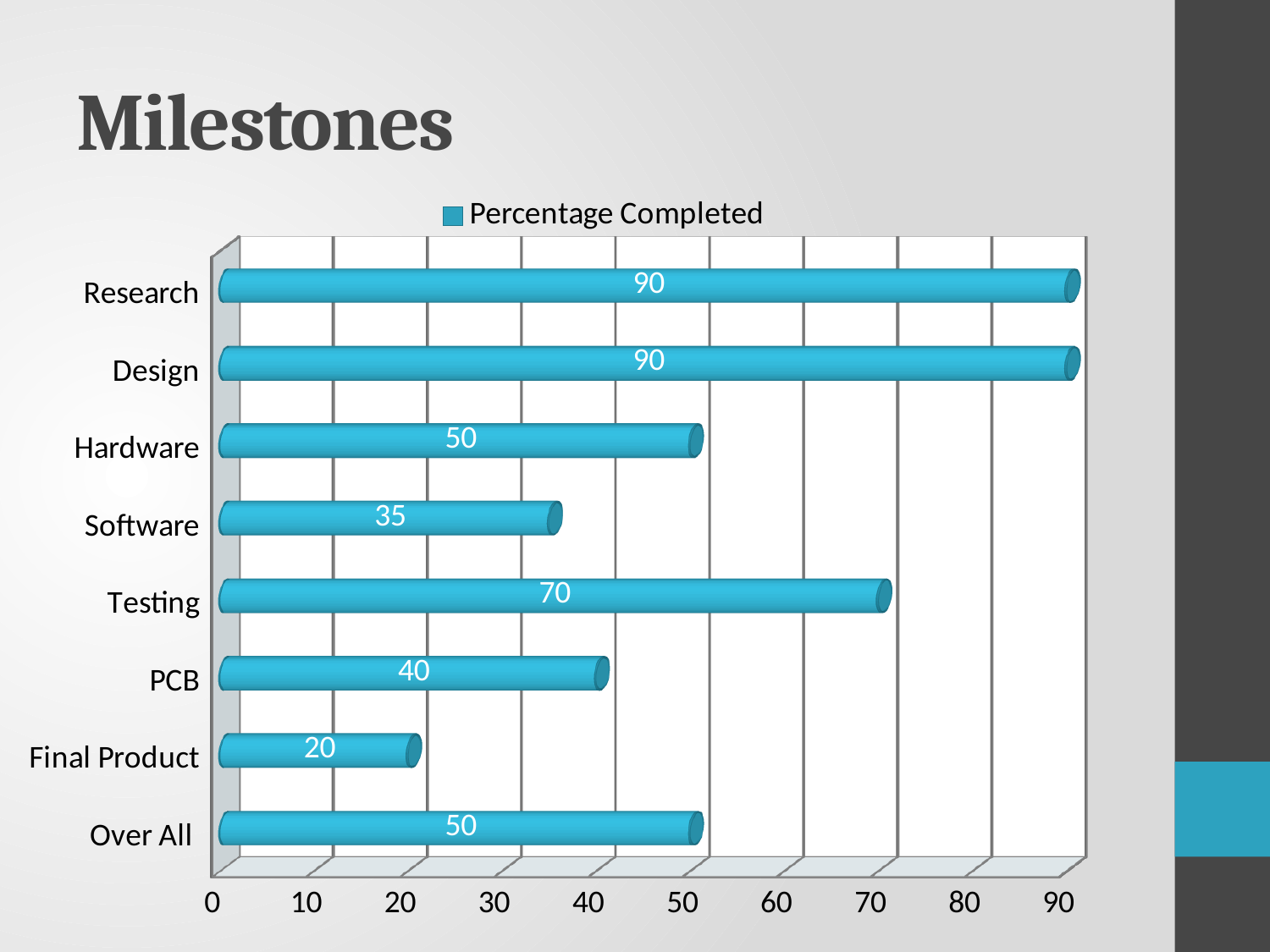
What is the Percentage Completed value for Final Product? 20 What is the difference between the Percentage Completed values for Testing and PCB? 30 How many categories are shown on the chart? 8 Which has a higher Percentage Completed, PCB or Testing? Testing What kind of chart is shown on the slide? Bar chart What is the Percentage Completed value for Software? 35 What is the difference between the Percentage Completed values for Research and Software? 55 Which category has the lowest Percentage Completed? Final Product What is the Percentage Completed value for Over All? 50 Which has a higher Percentage Completed, Hardware or Software? Hardware What series name does the legend show? Percentage Completed What is the Percentage Completed value for Testing? 70